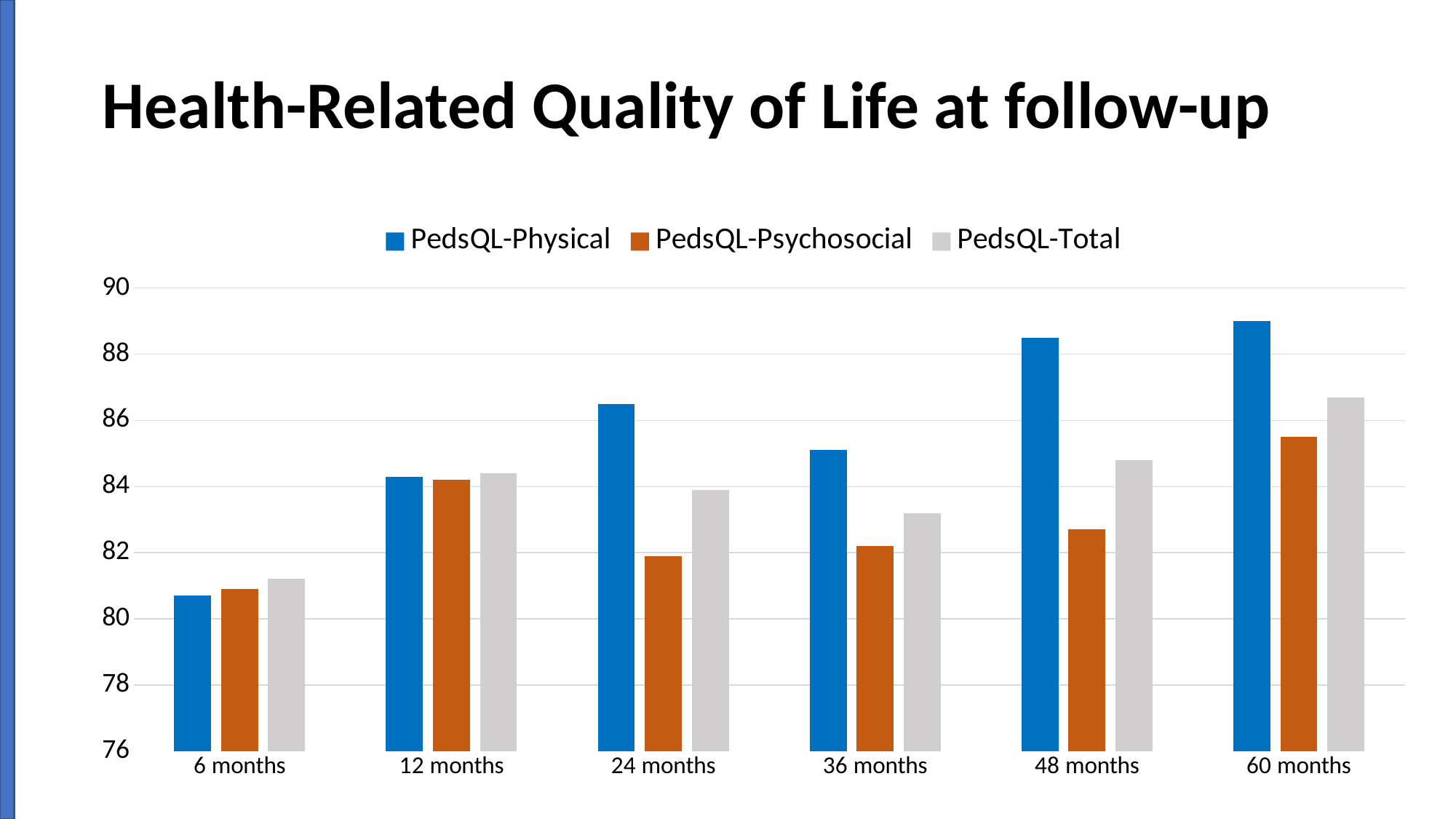
At 48 months, which is larger: PedsQL-Total or PedsQL-Psychosocial? PedsQL-Total At which follow-up time point is PedsQL-Total highest? 60 months How many series does the legend list? 3 What is the title of the chart on the slide? Health-Related Quality of Life at follow-up At 24 months, which is larger: PedsQL-Physical or PedsQL-Psychosocial? PedsQL-Physical At which follow-up time point is PedsQL-Psychosocial highest? 60 months Is the value for PedsQL-Total at 60 months greater or less than 86? greater What kind of chart is shown on the slide? bar chart How many follow-up time points are shown on the x axis? 6 At which follow-up time point is PedsQL-Physical lowest? 6 months Is the value for PedsQL-Physical at 48 months greater or less than 88? greater